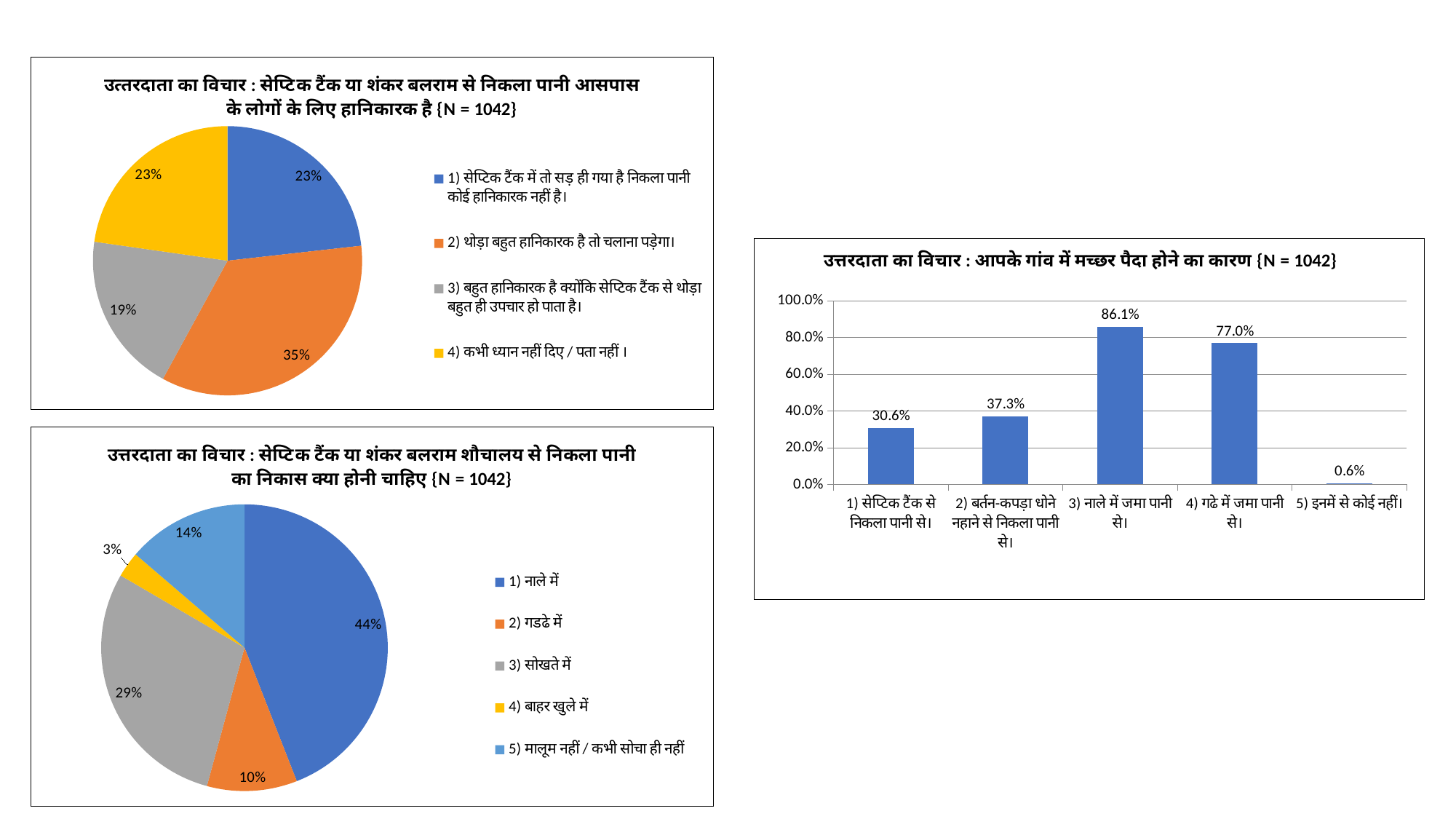
In the top-left pie chart, what share is shown for the slice '2) थोड़ा बहुत हानिकारक है तो चलाना पड़ेगा।'? 35% In the bar chart on the right, what is the value for '3) नाले में जमा पानी से।'? 86.1% How many legend entries does the bottom-left pie chart list? 5 In the bottom-left pie chart, what share is shown for '4) बाहर खुले में'? 3% In the bottom-left pie chart, what share is shown for '1) नाले में'? 44% In the bar chart on the right, which category has the lowest value? 5) इनमें से कोई नहीं। In the bar chart on the right, which is larger: the value for '1) सेप्टिक टैंक से निकला पानी से।' or '2) बर्तन-कपड़ा धोने नहाने से निकला पानी से।'? 2) बर्तन-कपड़ा धोने नहाने से निकला पानी से। How many slices does the top-left pie chart have? 4 What kind of chart is the chart on the right side of the slide? bar chart In the bottom-left pie chart, what is the difference between the shares for '3) सोखते में' and '2) गडढे में'? 19% In the bar chart on the right, what is the difference between the values for '3) नाले में जमा पानी से।' and '4) गढे में जमा पानी से।'? 9.1% In the top-left pie chart, which legend entry has the smallest slice? 3) बहुत हानिकारक है क्योंकि सेप्टिक टैंक से थोड़ा बहुत ही उपचार हो पाता है।